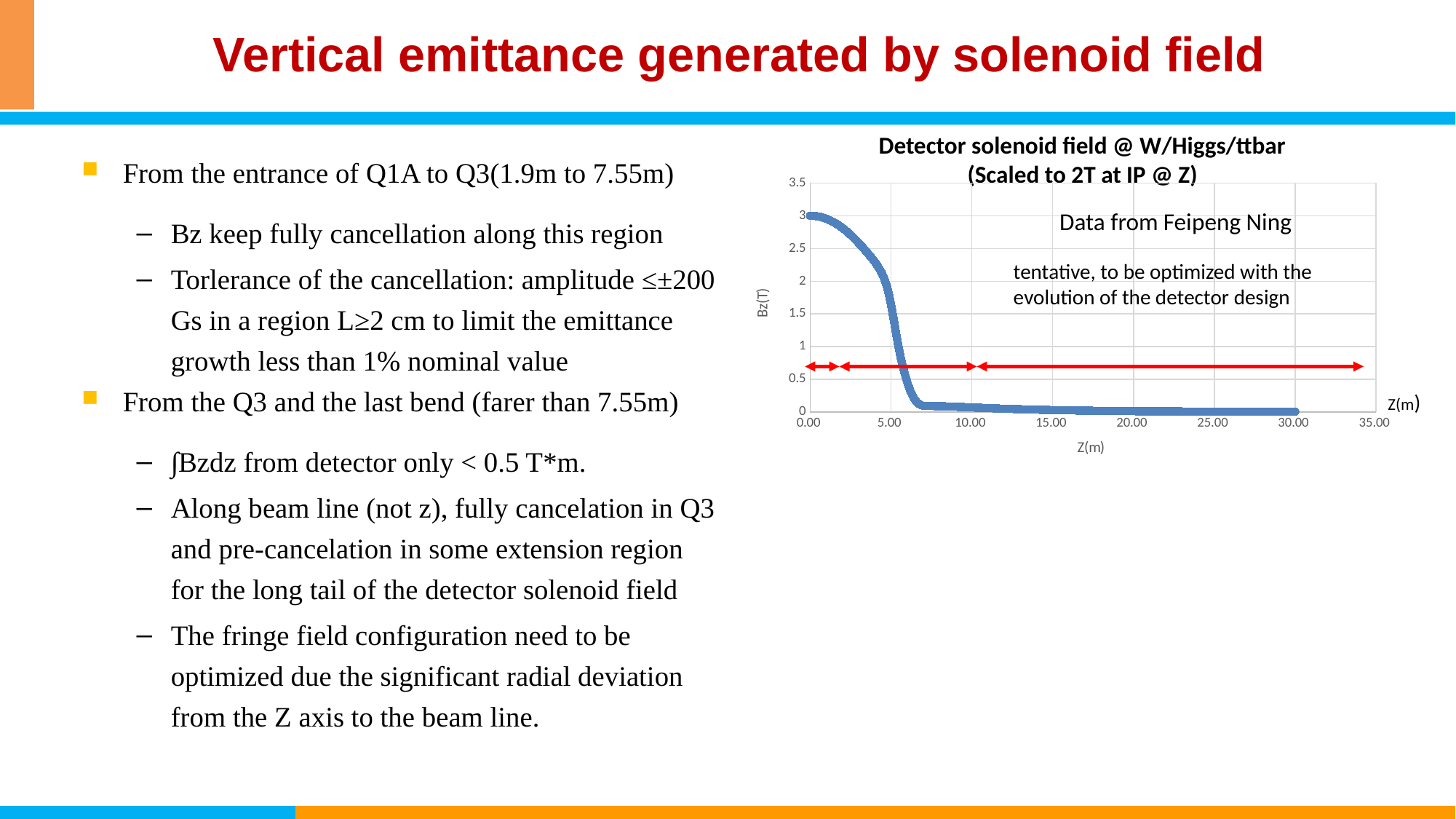
What is the title of the chart? Detector solenoid field @ W/Higgs/ttbar (Scaled to 2T at IP @ Z) At which Z value on the x axis is Bz highest? 0.00 Is the value of Bz at Z = 10.00 greater or less than 0.5? less Is the value of Bz at Z = 20.00 greater or less than 0.5? less Which is larger, the value of Bz at Z = 0.00 or at Z = 10.00? Z = 0.00 Does Bz rise or fall as Z increases along the x axis? fall What is the label of the vertical axis of the chart? Bz(T) Is the value of Bz at Z = 0.00 greater or less than 2.5? greater What kind of chart is shown on the slide? scatter chart